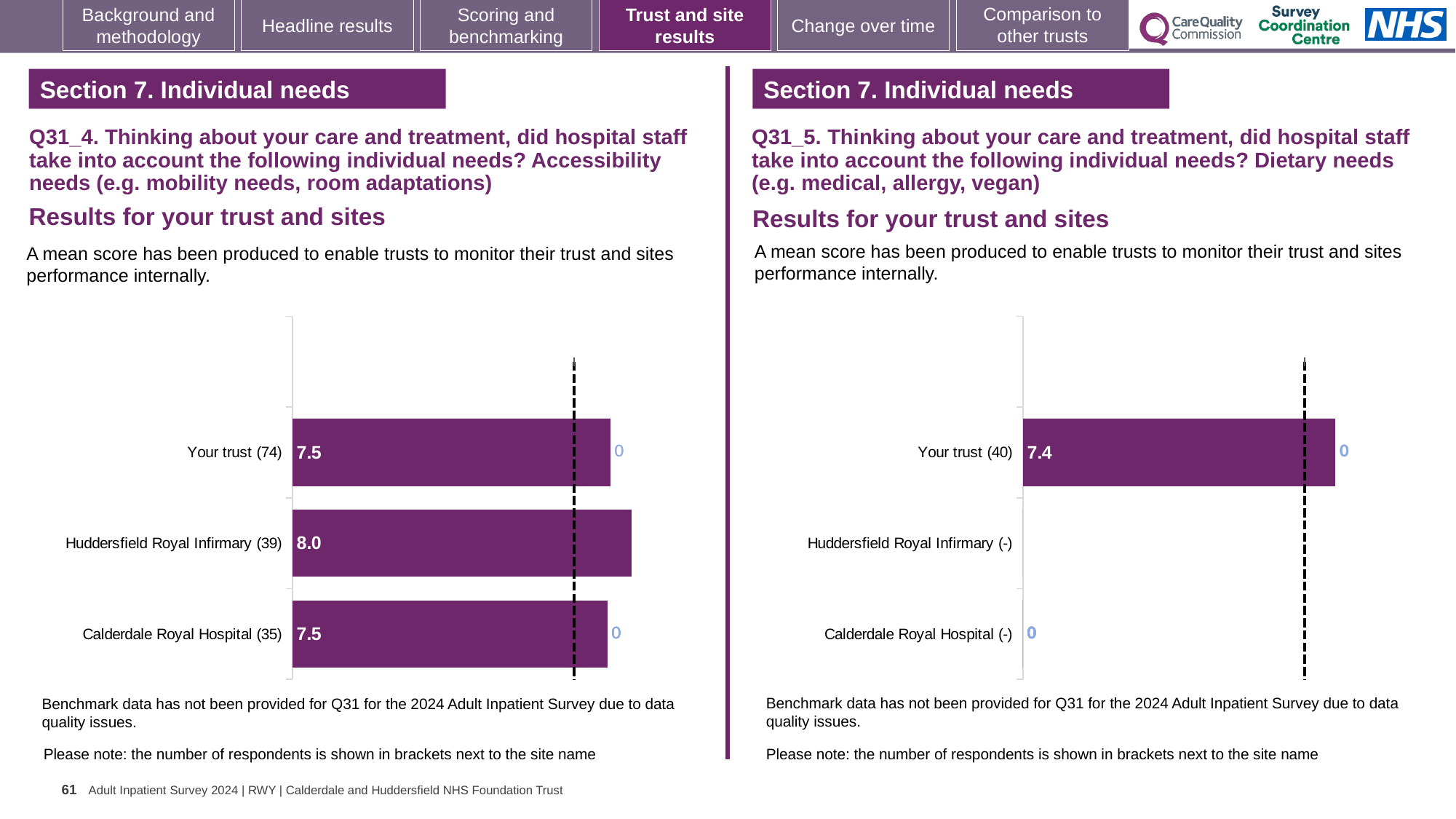
In the left chart (Q31_4, accessibility needs), what is the difference between the scores for Huddersfield Royal Infirmary and Calderdale Royal Hospital? 0.5 In the right chart (Q31_5, dietary needs), which categories have no score shown (marked with a dash)? Huddersfield Royal Infirmary and Calderdale Royal Hospital In the left chart (Q31_4, accessibility needs), how many categories are shown? 3 In the right chart (Q31_5, dietary needs), how many respondents are shown in brackets for Your trust? 40 In the left chart (Q31_4, accessibility needs), what is the mean score for Huddersfield Royal Infirmary? 8.0 In the left chart (Q31_4, accessibility needs), what is the mean score for Your trust? 7.5 In the left chart (Q31_4, accessibility needs), which is larger: the score for Huddersfield Royal Infirmary or the score for Your trust? Huddersfield Royal Infirmary What kind of chart is the left chart (Q31_4, accessibility needs)? Bar chart In the left chart (Q31_4, accessibility needs), which category has the highest mean score? Huddersfield Royal Infirmary In the right chart (Q31_5, dietary needs), what is the mean score for Your trust? 7.4 In the left chart (Q31_4, accessibility needs), how many respondents are shown in brackets for Huddersfield Royal Infirmary? 39 In the left chart (Q31_4, accessibility needs), what is the mean score for Calderdale Royal Hospital? 7.5